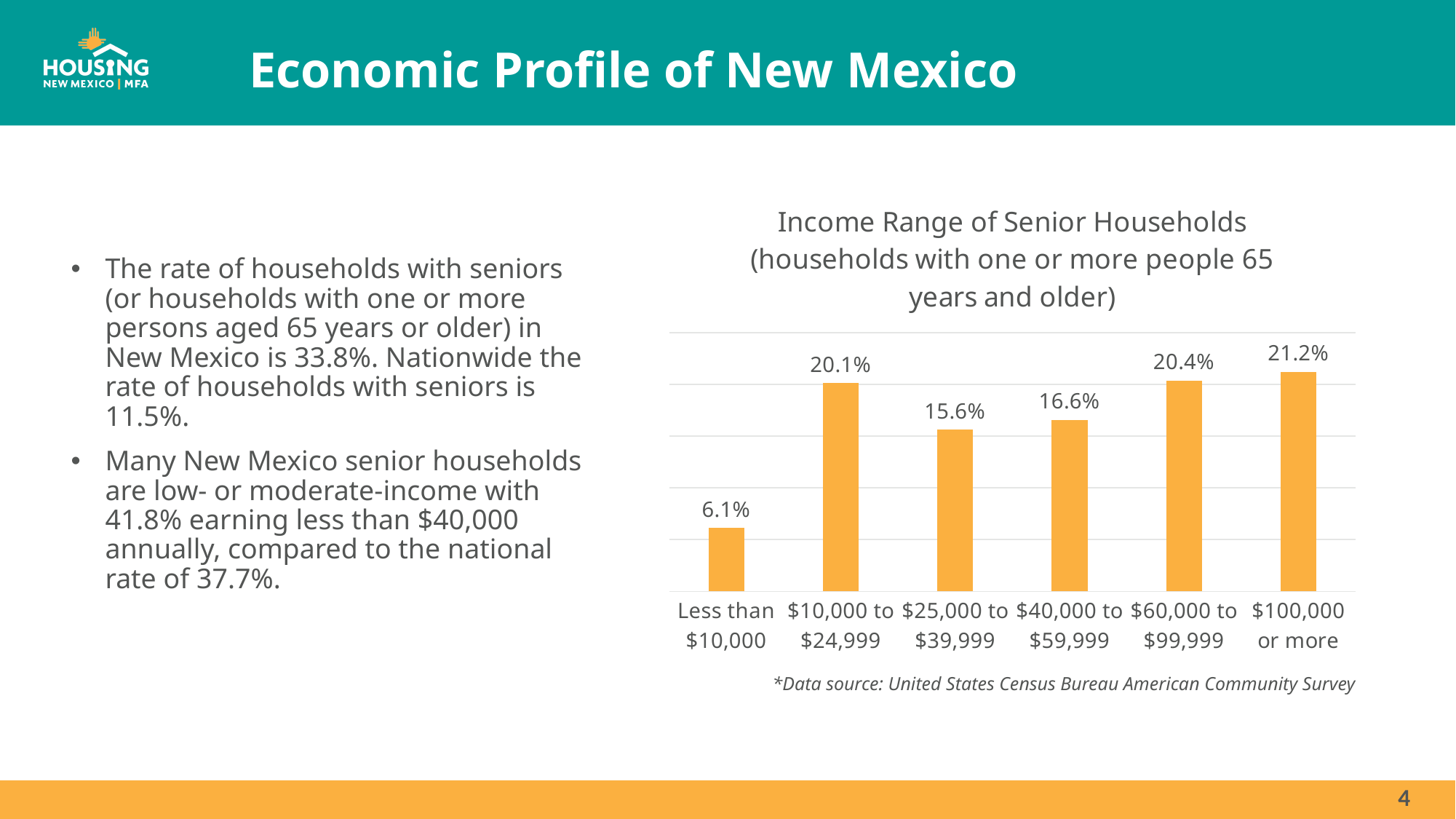
How many income ranges are shown in the chart? 6 What percentage of senior households have an income of less than $10,000? 6.1% What is the difference between the $10,000 to $24,999 value and the $25,000 to $39,999 value? 4.5% What type of chart is shown on the slide? Bar chart What is the value for the $25,000 to $39,999 income range? 15.6% Which is larger, the value for $40,000 to $59,999 or the value for $25,000 to $39,999? $40,000 to $59,999 Which income range has the lowest share of senior households? Less than $10,000 What is the difference between the $100,000 or more value and the Less than $10,000 value? 15.1% What percentage of senior households earn $60,000 to $99,999? 20.4% Which income range has the highest share of senior households? $100,000 or more What data source is cited below the chart? United States Census Bureau American Community Survey What is the title of the chart? Income Range of Senior Households (households with one or more people 65 years and older)